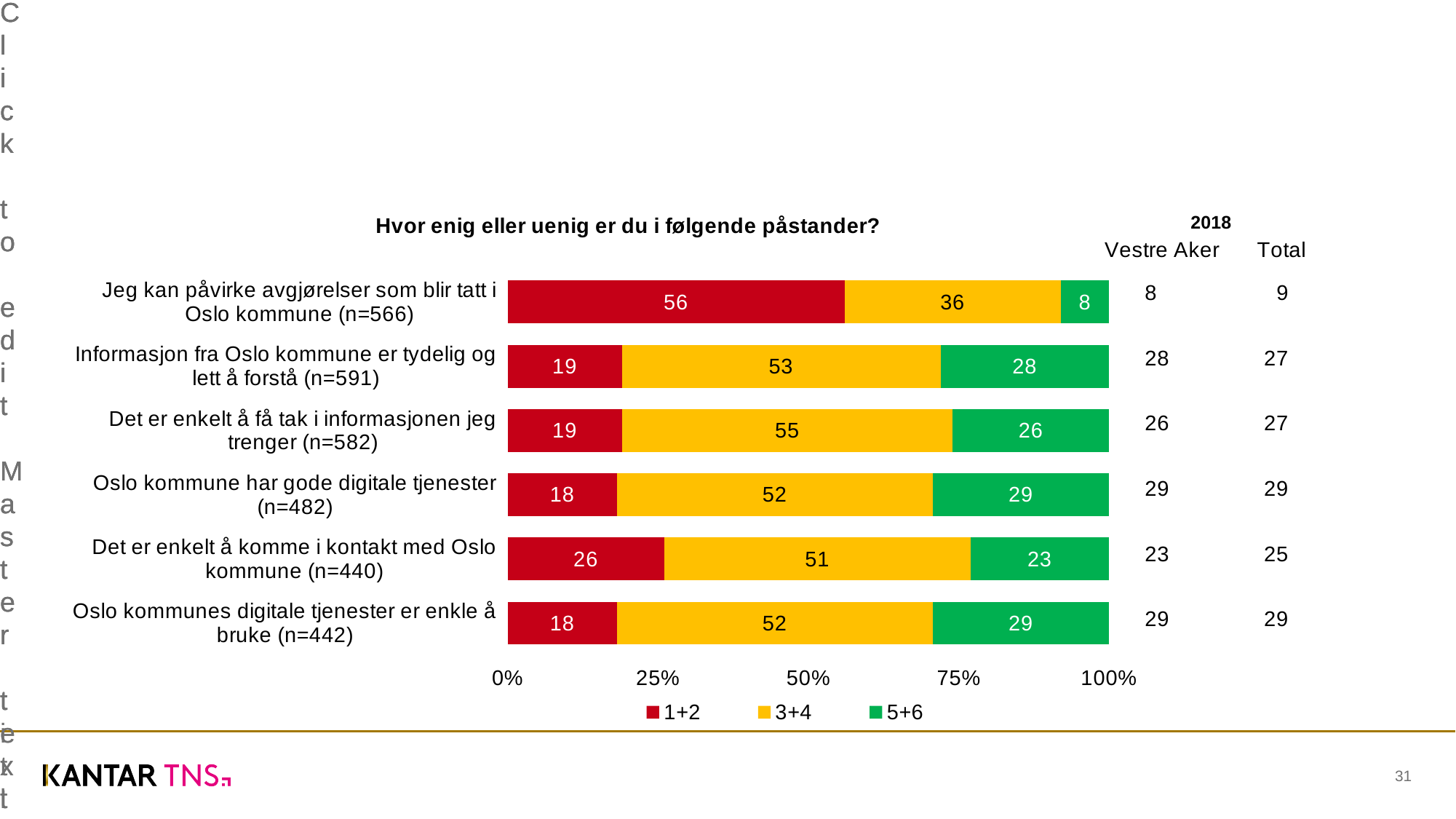
What kind of chart is shown on the slide? Stacked bar chart How many categories (statements) are shown in the chart? 6 What is the total of the stacked bar for "Oslo kommunes digitale tjenester er enkle å bruke (n=442)"? 99 What is the value of the 1+2 series for "Jeg kan påvirke avgjørelser som blir tatt i Oslo kommune (n=566)"? 56 How many series does the legend list? 3 What is the title of the chart? Hvor enig eller uenig er du i følgende påstander? What is the value of the 5+6 series for "Det er enkelt å komme i kontakt med Oslo kommune (n=440)"? 23 Which category has the highest value in the 1+2 series? Jeg kan påvirke avgjørelser som blir tatt i Oslo kommune (n=566) What is the difference between the 1+2 and 3+4 values for "Jeg kan påvirke avgjørelser som blir tatt i Oslo kommune (n=566)"? 20 Which is larger: the 5+6 value for "Informasjon fra Oslo kommune er tydelig og lett å forstå (n=591)" or for "Det er enkelt å få tak i informasjonen jeg trenger (n=582)"? Informasjon fra Oslo kommune er tydelig og lett å forstå (n=591) Which category has the lowest value in the 5+6 series? Jeg kan påvirke avgjørelser som blir tatt i Oslo kommune (n=566) What is the value of the 3+4 series for "Det er enkelt å få tak i informasjonen jeg trenger (n=582)"? 55